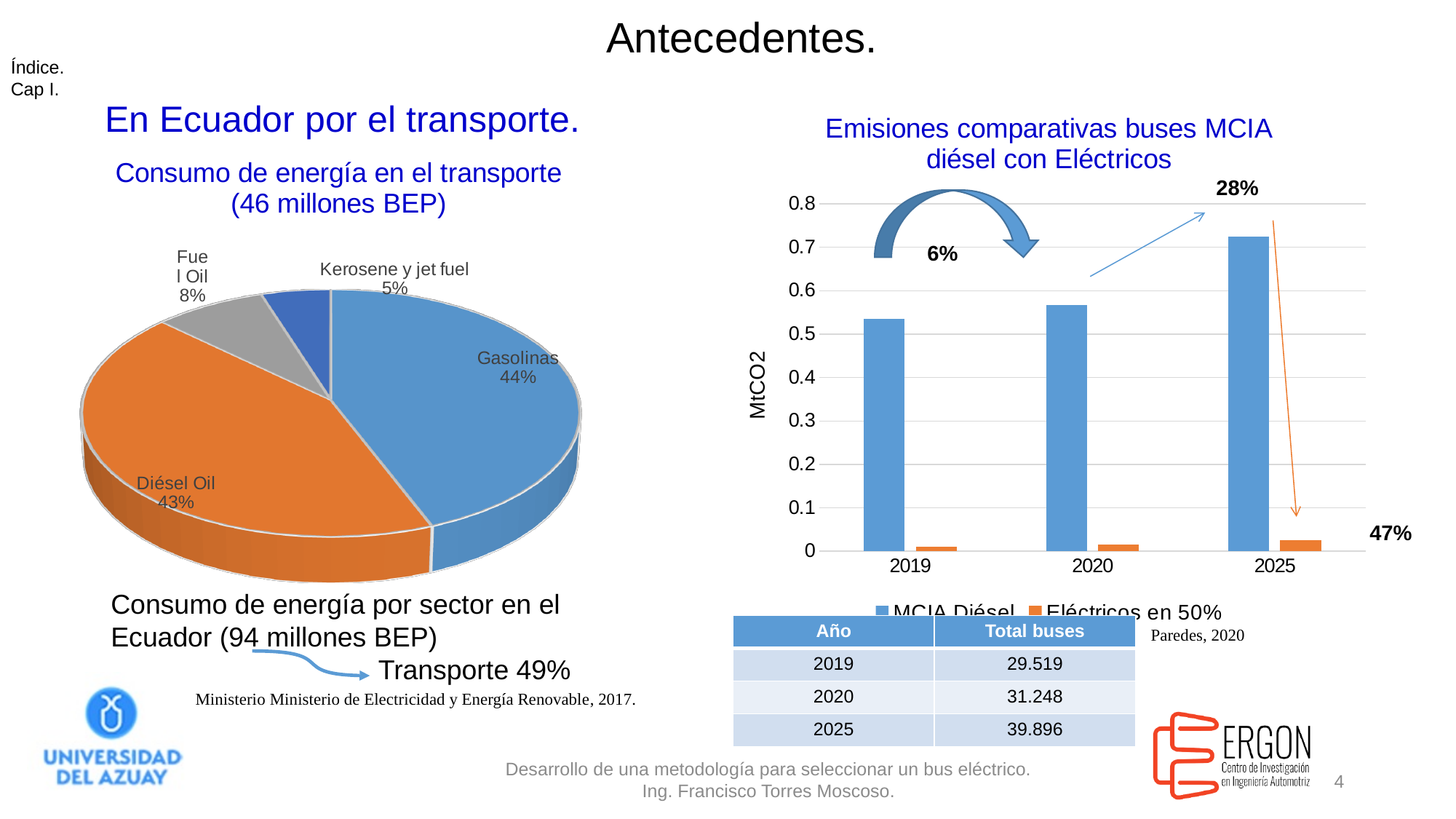
In the bar chart on the right, how many series does the legend list? 2 In the bar chart on the right, do the MCIA Diésel values rise or fall from 2019 to 2025? rise In the bar chart on the right, is the MCIA Diésel value for 2025 greater or less than 0.6? greater In the pie chart on the left, how many slices are there? 4 What type of chart is the 'Emisiones comparativas buses MCIA diésel con Eléctricos' chart on the right? bar chart In the pie chart on the left, what share does Gasolinas have? 44% In the pie chart on the left, what share does Diésel Oil have? 43% In the pie chart on the left, what share does Kerosene y jet fuel have? 5% What type of chart is the 'Consumo de energía en el transporte' chart on the left? pie chart In the pie chart on the left, what is the difference between the Gasolinas share and the Fuel Oil share? 36% In the bar chart on the right, how many years are shown on the x axis? 3 In the pie chart on the left, which slice is the smallest? Kerosene y jet fuel